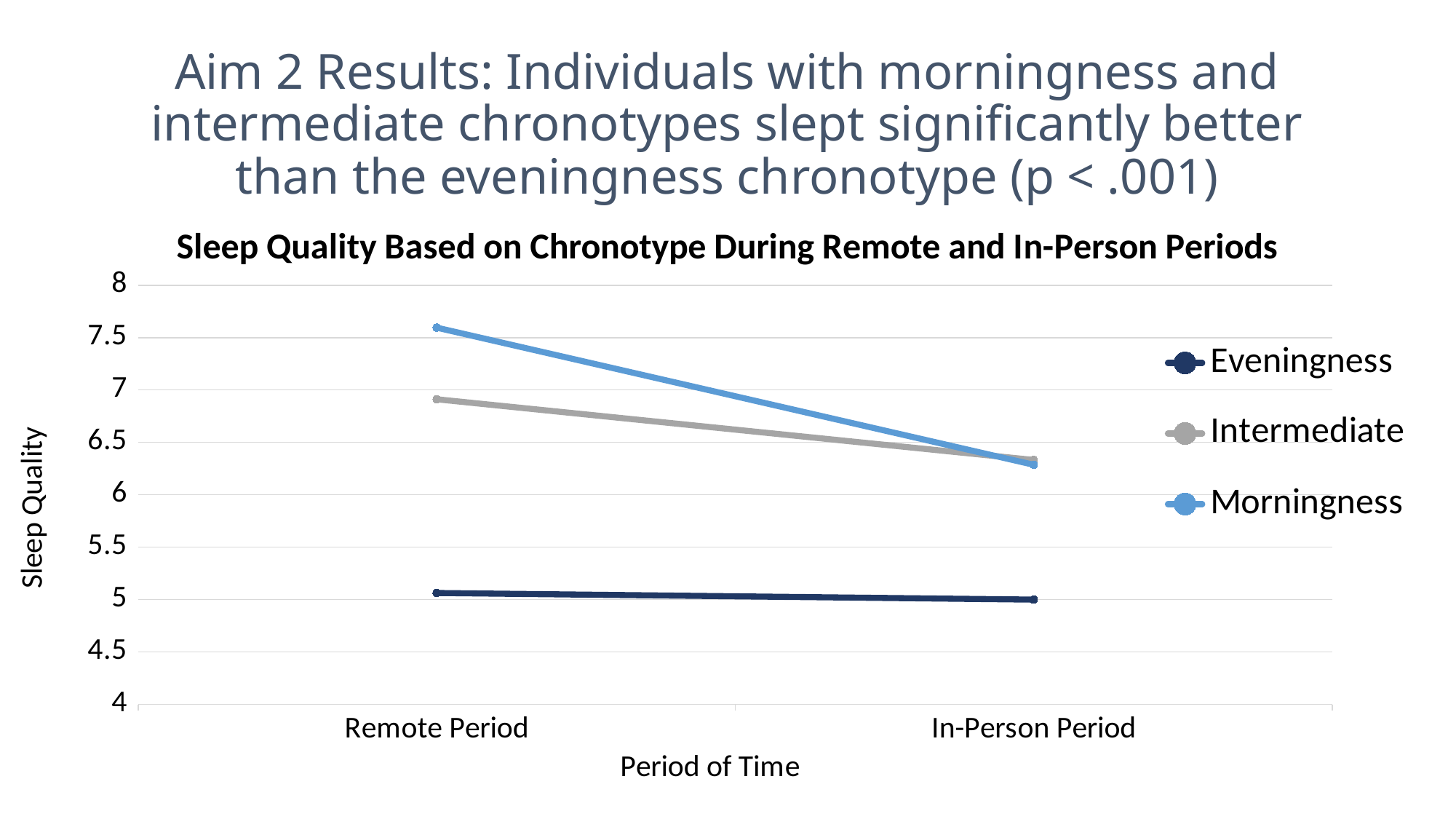
Is the sleep quality for Morningness during the Remote Period greater or less than 7? greater Is the sleep quality for Morningness during the In-Person Period greater or less than 6.5? less What is the title of the chart? Sleep Quality Based on Chronotype During Remote and In-Person Periods How many series does the legend list? 3 How many periods are shown on the x axis? 2 What kind of chart is shown on the slide? line chart Which chronotype has the highest sleep quality during the Remote Period? Morningness Is the sleep quality for Eveningness during the In-Person Period greater or less than 5.5? less Which chronotype has the lowest sleep quality during the In-Person Period? Eveningness Does the sleep quality for Morningness rise or fall from the Remote Period to the In-Person Period? fall During the In-Person Period, which has higher sleep quality: Intermediate or Eveningness? Intermediate